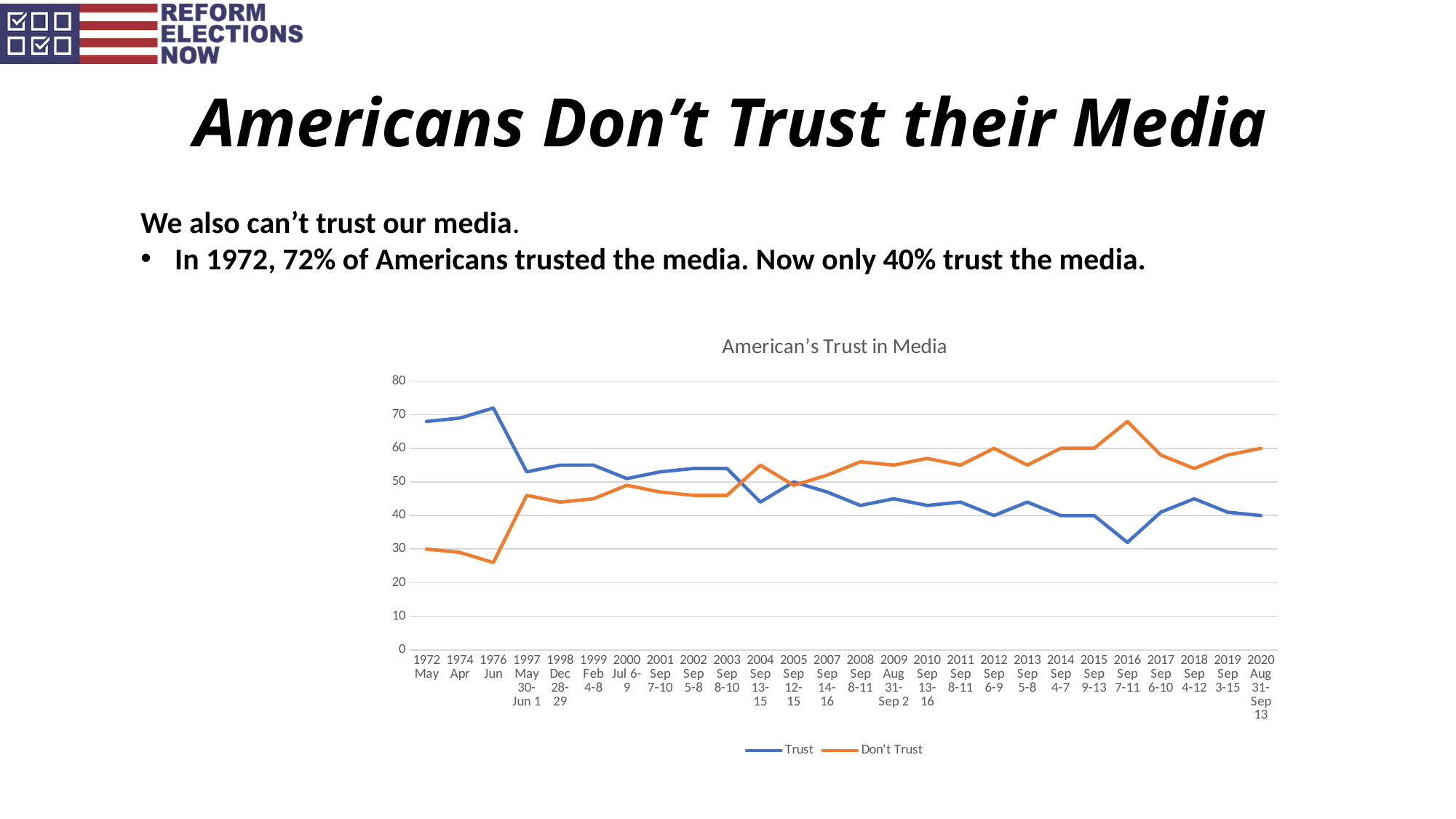
How many survey dates are plotted along the x axis of the chart? 26 In which year does the Don't Trust series reach its highest value? 2016 In which year does the Trust series reach its lowest value? 2016 How many series does the legend of the chart list? 2 What is the title of the chart? American's Trust in Media In 2020, which series has the larger value, Trust or Don't Trust? Don't Trust Is the Don't Trust value for 1976 greater or less than 30? less What are the two series named in the chart's legend? Trust and Don't Trust What kind of chart is shown on the slide? line chart Overall, does the Trust series rise or fall from 1972 to 2020? fall In which year does the Trust series reach its highest value? 1976 Is the Trust value for 1972 greater or less than 60? greater